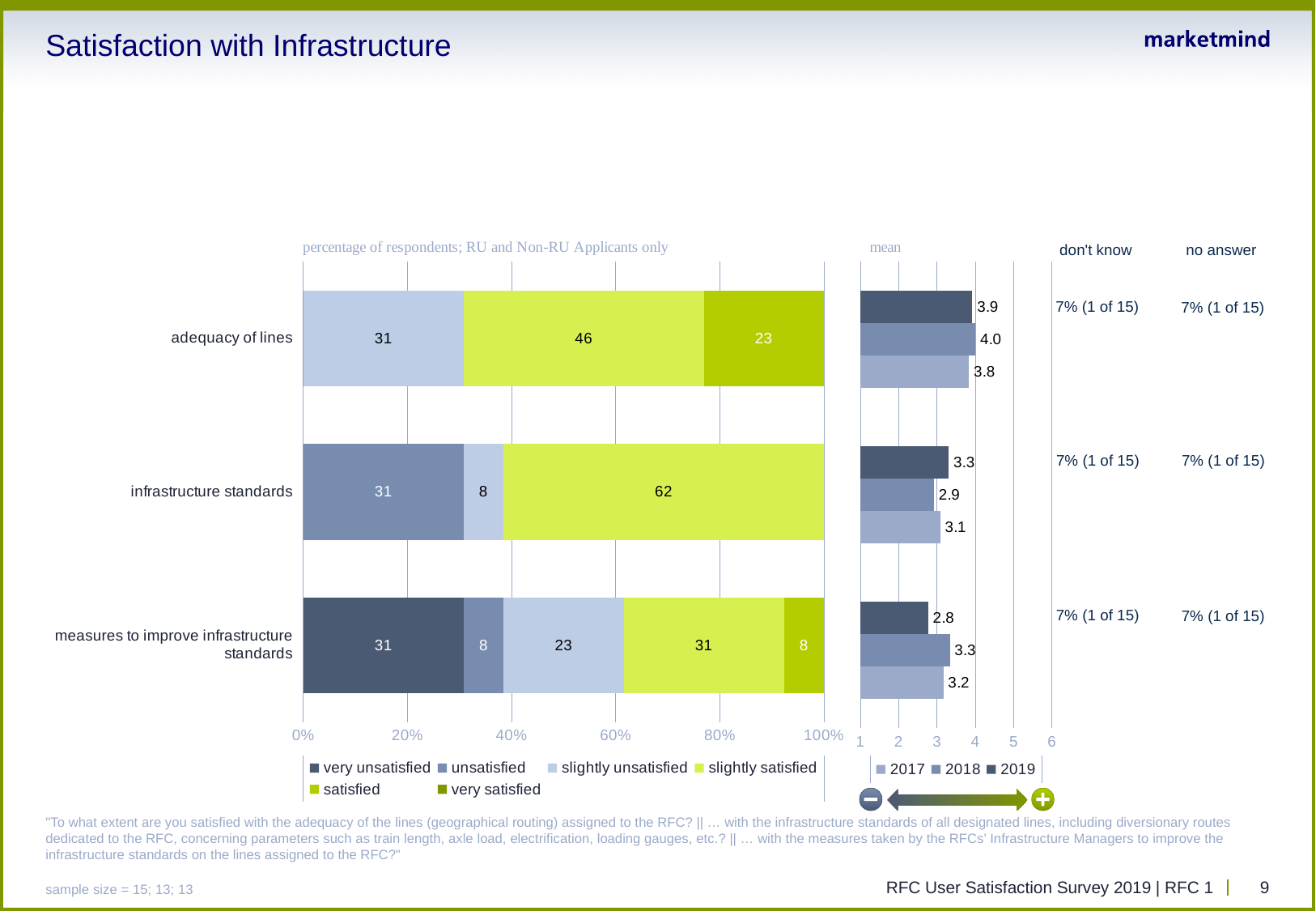
In the percentage-of-respondents stacked bar chart, what is the combined percentage of slightly satisfied and very satisfied respondents for adequacy of lines? 46 In the mean chart, what is the difference between the 2019 and 2018 means for infrastructure standards? 0.4 In the percentage-of-respondents stacked bar chart, what percentage of respondents were very unsatisfied with the measures to improve infrastructure standards? 31 What kind of chart is the percentage-of-respondents chart on the left? Stacked bar chart How many series does the legend of the mean chart list? 3 In the percentage-of-respondents stacked bar chart, how many categories (rows) are shown? 3 In the percentage-of-respondents stacked bar chart, what percentage of respondents were slightly satisfied with infrastructure standards? 62 How many series does the legend of the percentage-of-respondents stacked bar chart list? 6 In the percentage-of-respondents stacked bar chart, what percentage of respondents were slightly satisfied with the adequacy of lines? 46 In the mean chart, what is the 2019 mean for measures to improve infrastructure standards? 2.8 In the mean chart, which category has the highest 2019 mean? adequacy of lines In the mean chart, what is the 2018 mean for adequacy of lines? 4.0